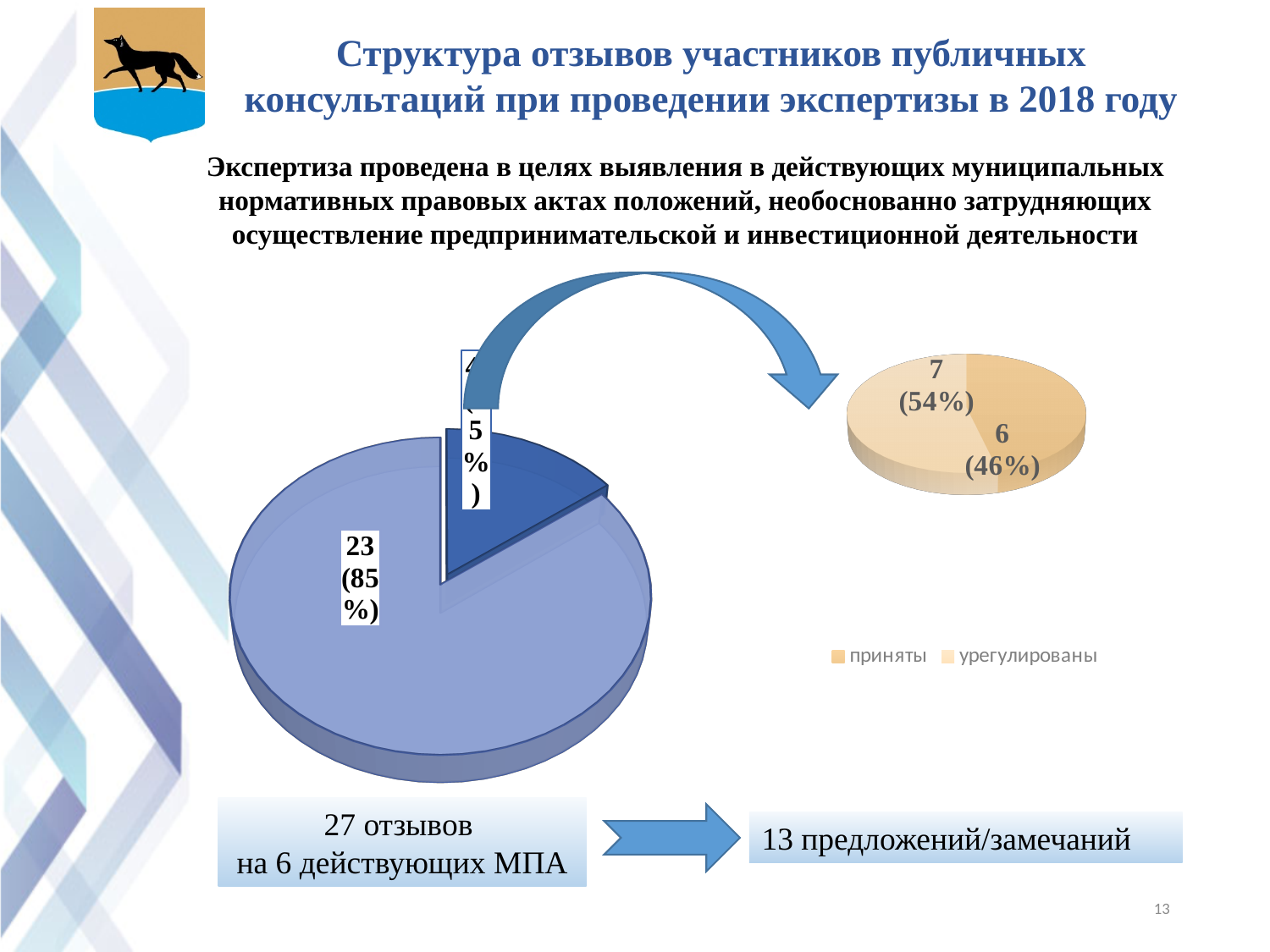
What kind of chart is the large chart on the left of the slide? pie chart In the small pie chart on the right, what is the total of the two slice values? 13 In the large pie chart on the left, what value is shown for the largest slice? 23 In the small pie chart on the right, what value is shown for the larger slice? 7 In the small pie chart on the right, what share of the pie does the smaller slice represent? 46% What kind of chart is the small chart on the right of the slide? pie chart In the large pie chart on the left, what share of the pie does the largest slice represent? 85% In the small pie chart on the right, what share of the pie does the larger slice represent? 54% How many entries does the legend of the small pie chart on the right list? 2 In the small pie chart on the right, what is the difference between the two slice values? 1 In the small pie chart on the right, what value is shown for the smaller slice? 6 How many slices does the large pie chart on the left have? 2